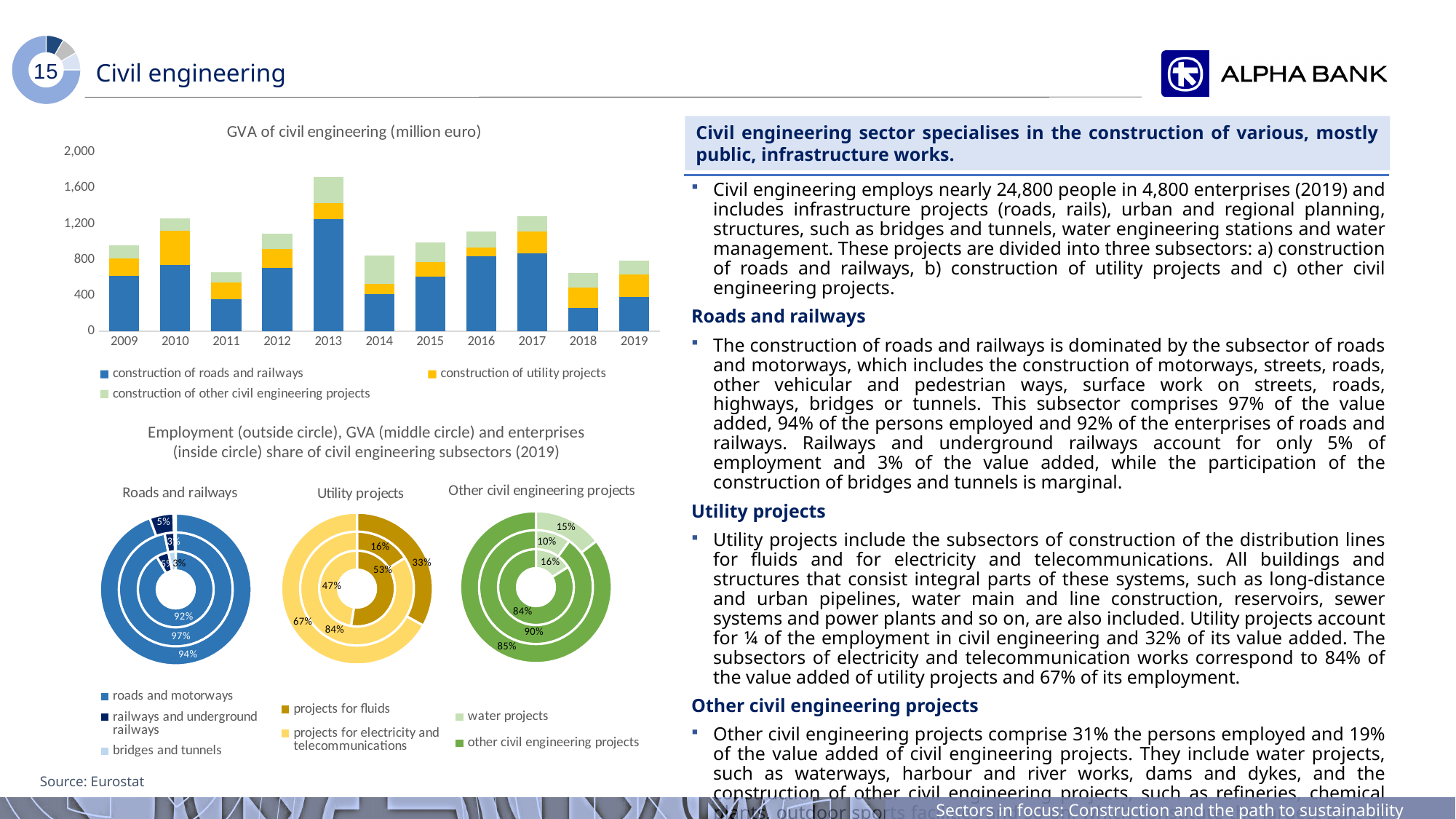
In the 'Utility projects' donut chart, what is the difference in employment (outside circle) share between projects for electricity and telecommunications and projects for fluids? 34 percentage points In the 'GVA of civil engineering (million euro)' chart, which year has the highest total GVA? 2013 In the 'Roads and railways' donut chart, what is the employment (outside circle) share of roads and motorways? 94% In the 'GVA of civil engineering (million euro)' chart, does the total GVA rise or fall from 2017 to 2018? fall How many series does the legend of the 'GVA of civil engineering (million euro)' chart list? 3 In the 'Other civil engineering projects' donut chart, what is the employment (outside circle) share of water projects? 15% What kind of chart is the 'GVA of civil engineering (million euro)' chart? stacked bar chart In the 'GVA of civil engineering (million euro)' chart, is the total GVA for 2013 larger than that for 2014? yes In the 'GVA of civil engineering (million euro)' chart, is the value for construction of roads and railways in 2009 greater or less than 800? less In the 'GVA of civil engineering (million euro)' chart, is the total GVA for 2013 greater or less than 1,600? greater In the 'Utility projects' donut chart, what is the GVA (middle circle) share of projects for electricity and telecommunications? 84% How many years are shown on the x axis of the 'GVA of civil engineering (million euro)' chart? 11